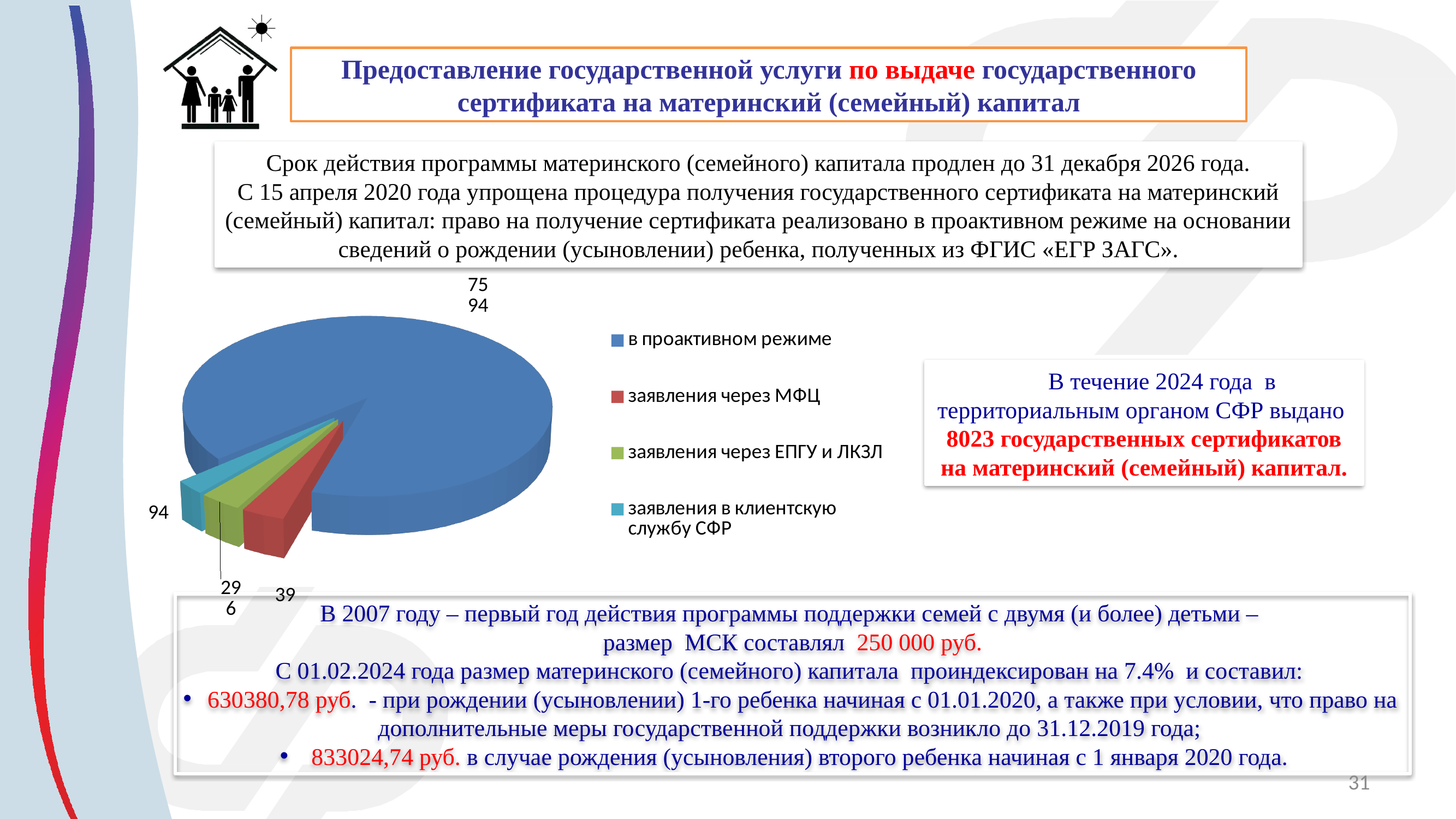
What is the value for 'заявления через ЕПГУ и ЛКЗЛ' in the pie chart? 296 What colour is the slice for 'в проактивном режиме' in the pie chart? blue What is the value for 'заявления в клиентскую службу СФР' in the pie chart? 94 What kind of chart is shown on the slide? pie chart Which is larger in the pie chart: 'заявления через ЕПГУ и ЛКЗЛ' or 'заявления в клиентскую службу СФР'? заявления через ЕПГУ и ЛКЗЛ What is the value for 'в проактивном режиме' in the pie chart? 7594 What is the value for 'заявления через МФЦ' in the pie chart? 39 What is the difference between the values for 'заявления в клиентскую службу СФР' and 'заявления через МФЦ' in the pie chart? 55 How many slices does the pie chart have? 4 How many entries does the legend of the pie chart list? 4 Which category has the largest slice in the pie chart? в проактивном режиме